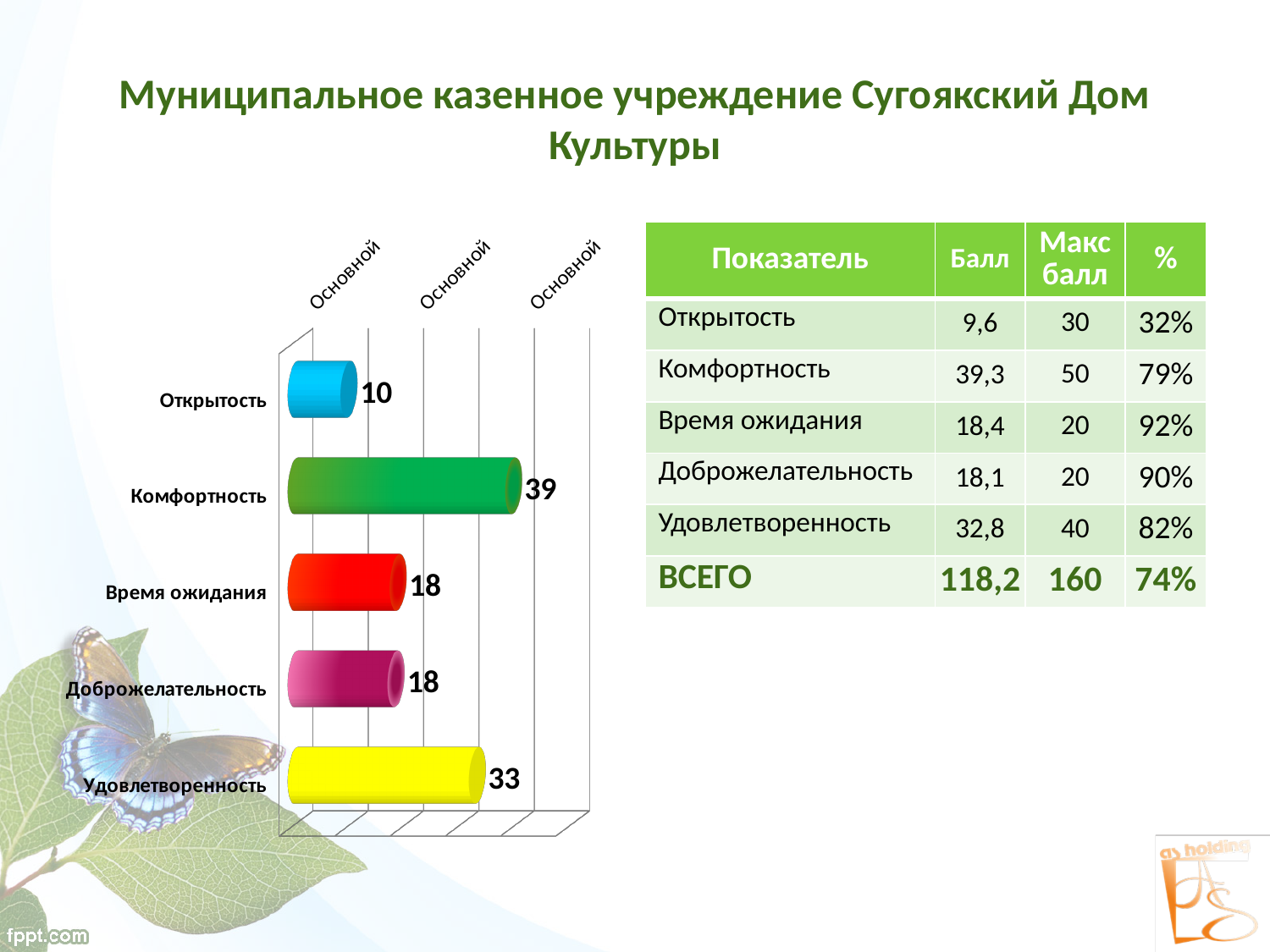
What value is shown for Удовлетворенность in the bar chart? 33 What is the difference between the values for Комфортность and Удовлетворенность in the bar chart? 6 What is the difference between the values for Время ожидания and Открытость in the bar chart? 8 Which category has the lowest value in the bar chart? Открытость What value is shown for Комфортность in the bar chart? 39 What colour is the bar for Удовлетворенность in the bar chart? Yellow What kind of chart is shown on the left of the slide? Bar chart What value is shown for Время ожидания in the bar chart? 18 In the bar chart, which is larger: the value for Удовлетворенность or the value for Доброжелательность? Удовлетворенность What value is shown for Открытость in the bar chart? 10 How many categories are plotted in the bar chart? 5 Which category has the highest value in the bar chart? Комфортность